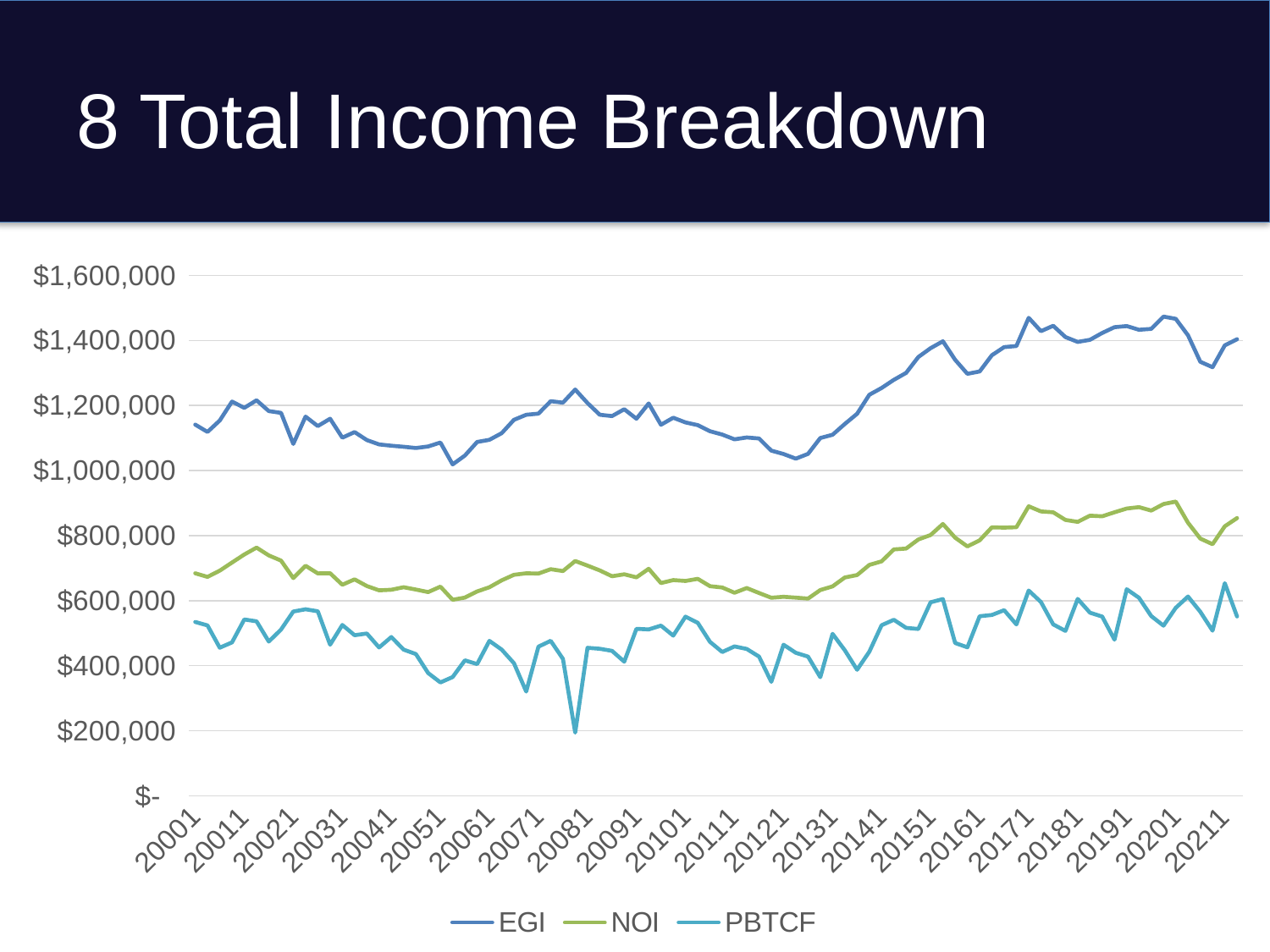
Is the value of EGI at 20001 greater or less than $1,000,000? greater Which series has the lowest values across the whole chart? PBTCF Near which x-axis label does PBTCF reach its lowest point? 20081 Which series has the highest values across the whole chart? EGI Does EGI rise or fall between 20131 and 20171? Rise At 20001, which is larger, EGI or NOI? EGI Is the value of PBTCF at 20081 greater or less than $400,000? greater What kind of chart is shown on the slide? Line chart Is the value of NOI at 20051 greater or less than $800,000? less How many series does the legend list? 3 What are the names of the series listed in the legend? EGI, NOI, PBTCF